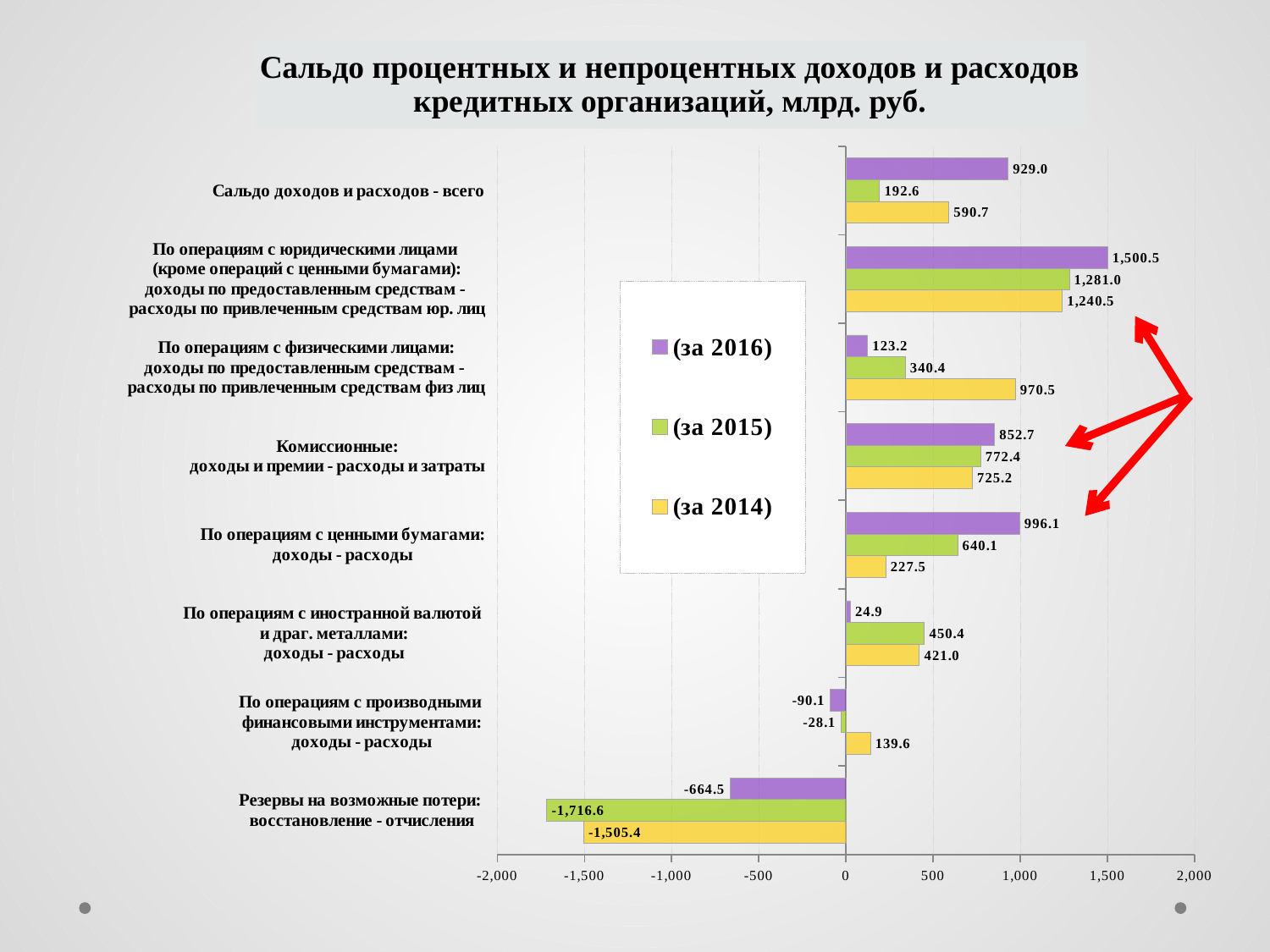
How many categories are shown on the chart? 8 For «По операциям с ценными бумагами: доходы - расходы», which series has the larger value, «(за 2016)» or «(за 2014)»? (за 2016) Which category has the lowest value for the series «(за 2015)»? Резервы на возможные потери: восстановление - отчисления What is the difference between the «(за 2016)» and «(за 2015)» values for «Сальдо доходов и расходов - всего»? 736.4 What is the difference between the «(за 2016)» and «(за 2014)» values for «Комиссионные: доходы и премии - расходы и затраты»? 127.5 What is the value for «По операциям с иностранной валютой и драг. металлами: доходы - расходы» for the series «(за 2016)»? 24.9 Which category has the highest value for the series «(за 2016)»? По операциям с юридическими лицами (кроме операций с ценными бумагами) How many series does the legend list? 3 What is the value for «Комиссионные: доходы и премии - расходы и затраты» for the series «(за 2016)»? 852.7 What is the value for «Резервы на возможные потери: восстановление - отчисления» for the series «(за 2015)»? -1,716.6 What kind of chart is shown on the slide? Bar chart What is the value for «Сальдо доходов и расходов - всего» for the series «(за 2014)»? 590.7